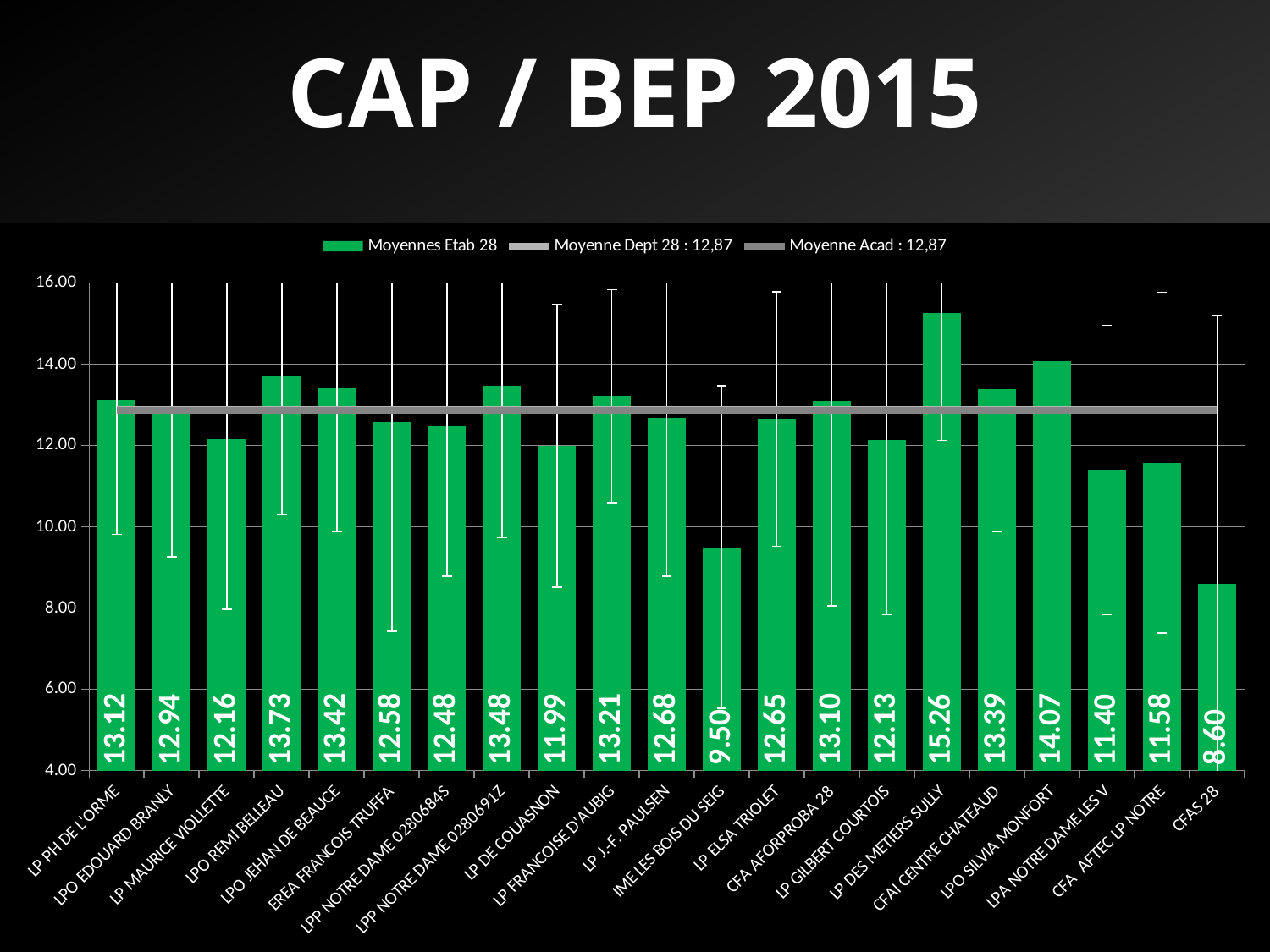
How many establishments are shown on the x axis? 21 Which establishment has the lowest average? CFAS 28 What is the value for IME LES BOIS DU SEIG? 9.50 Is the value for LPA NOTRE DAME LES V greater or less than 12.00? less What is the value for LP DES METIERS SULLY? 15.26 What value does the legend give for Moyenne Dept 28? 12,87 What kind of chart is shown on the slide? bar chart What is the difference between the values for LP DES METIERS SULLY and CFAS 28? 6.66 Which is larger, the value for LPO REMI BELLEAU or the value for LPO JEHAN DE BEAUCE? LPO REMI BELLEAU Which establishment has the highest average? LP DES METIERS SULLY How many series does the legend list? 3 What is the value for LPO SILVIA MONFORT? 14.07